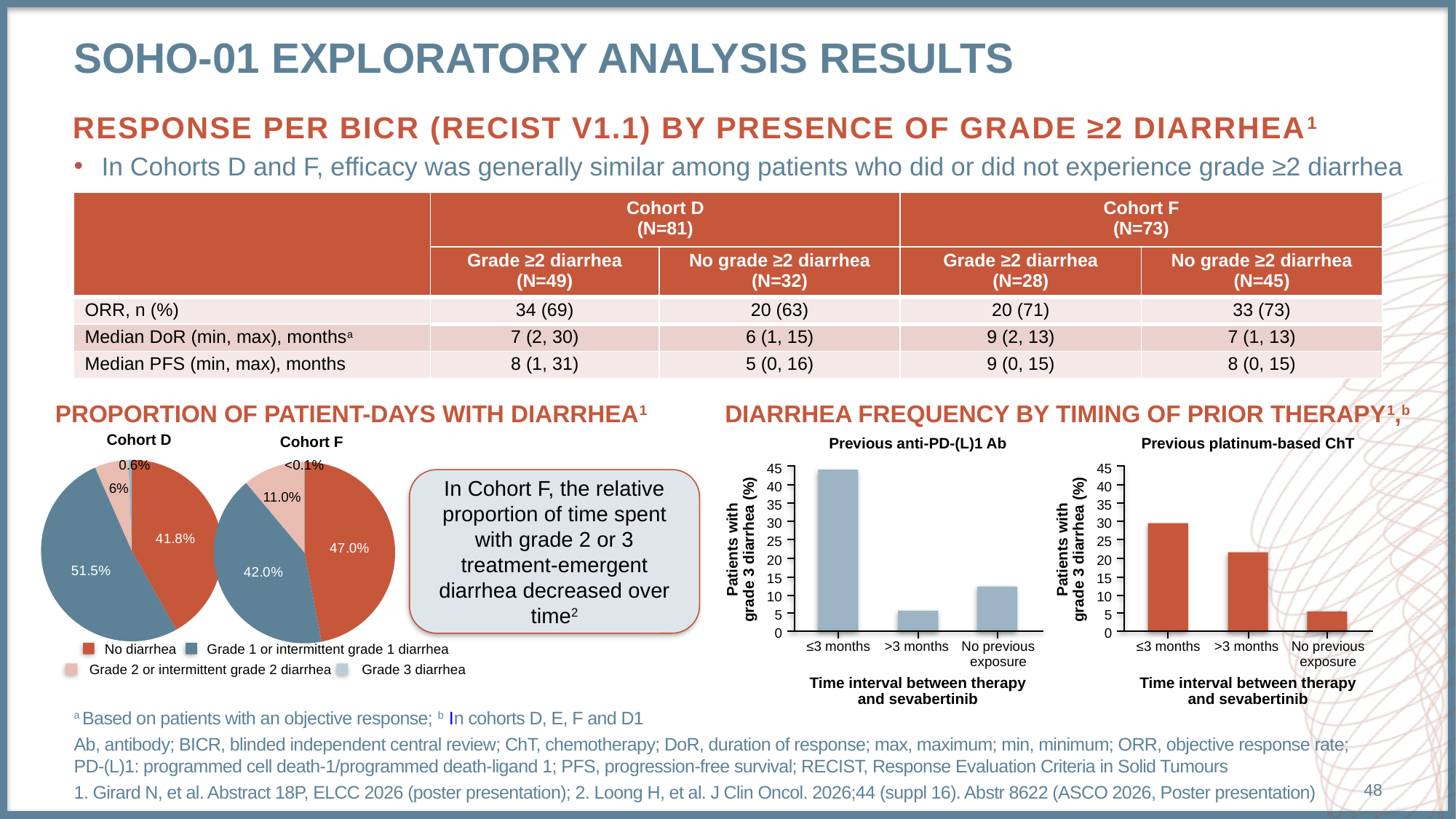
In the Previous platinum-based ChT bar chart, is the value for No previous exposure greater or less than 10? less In the Previous anti-PD-(L)1 Ab bar chart, which time interval has the highest percentage of patients with grade 3 diarrhea? ≤3 months In the Cohort F pie chart, which category has the smallest slice? Grade 3 diarrhea In the Cohort F pie chart, what percentage of patient-days is shown for No diarrhea? 47.0% In the Previous anti-PD-(L)1 Ab bar chart, is the value for ≤3 months greater or less than 40? greater In the Cohort D pie chart, what is the difference in percentage points between Grade 1 or intermittent grade 1 diarrhea and No diarrhea? 9.7 In the Cohort D pie chart, what percentage of patient-days is shown for Grade 1 or intermittent grade 1 diarrhea? 51.5% In the Previous anti-PD-(L)1 Ab bar chart, which is larger: the value for >3 months or for No previous exposure? No previous exposure In the Cohort D pie chart, which category has the largest slice? Grade 1 or intermittent grade 1 diarrhea What kind of chart is the Previous platinum-based ChT chart? bar chart In the Cohort F pie chart, what percentage is shown for Grade 2 or intermittent grade 2 diarrhea? 11.0% In the Previous platinum-based ChT chart, do the values rise or fall from ≤3 months to No previous exposure? fall